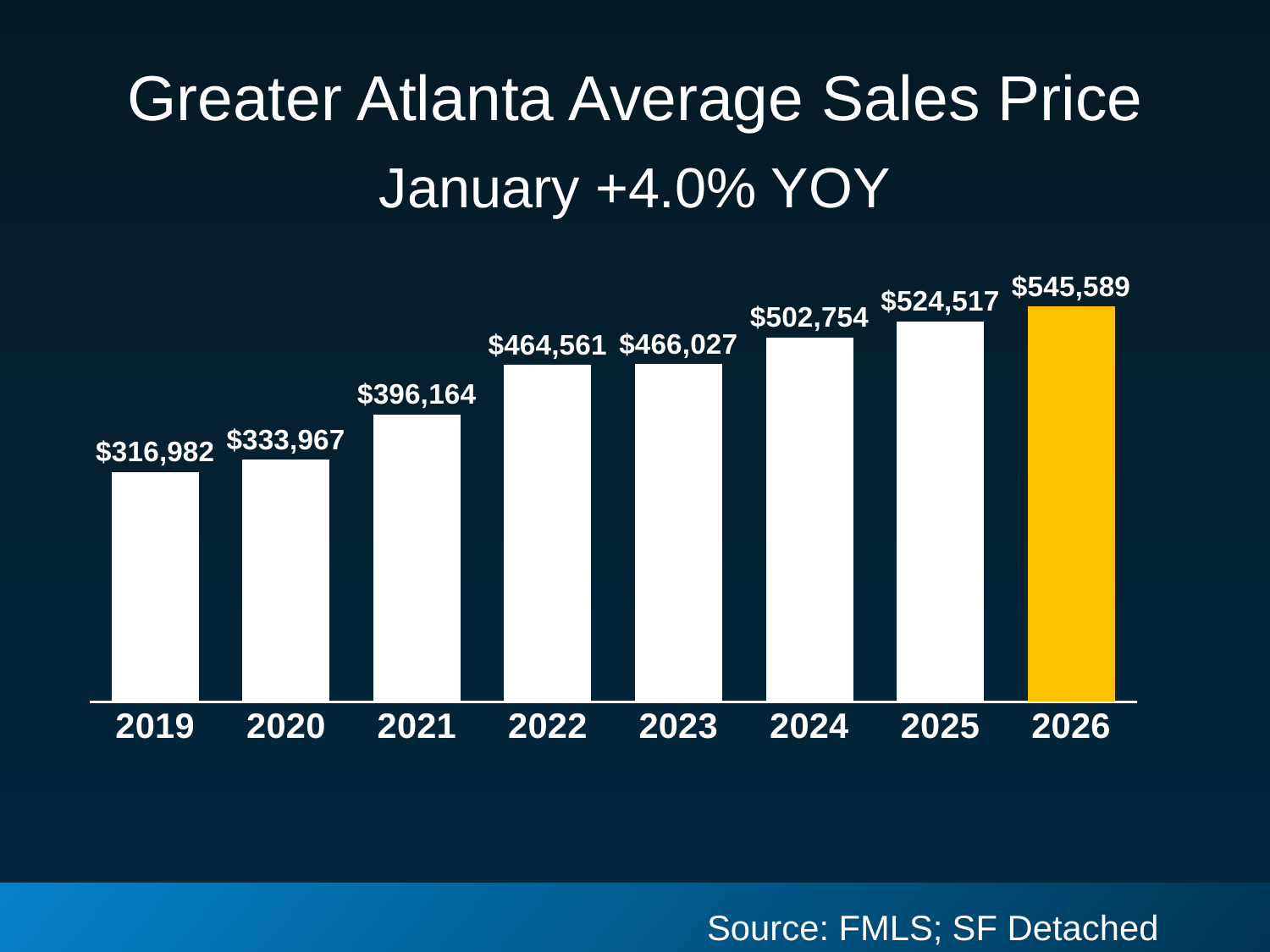
Which is larger, the average sales price for 2022 or for 2021? 2022 What is the difference between the 2026 and 2025 average sales prices? $21,072 What is the difference between the 2020 and 2019 average sales prices? $16,985 Do the average sales prices rise or fall from 2019 to 2026? Rise How many years are shown on the chart? 8 What is the average sales price for 2021? $396,164 What is the average sales price for 2024? $502,754 What is the average sales price for 2026? $545,589 What kind of chart is shown on the slide? Bar chart Which year's bar is coloured yellow instead of white? 2026 Which year has the highest average sales price? 2026 Which year has the lowest average sales price? 2019